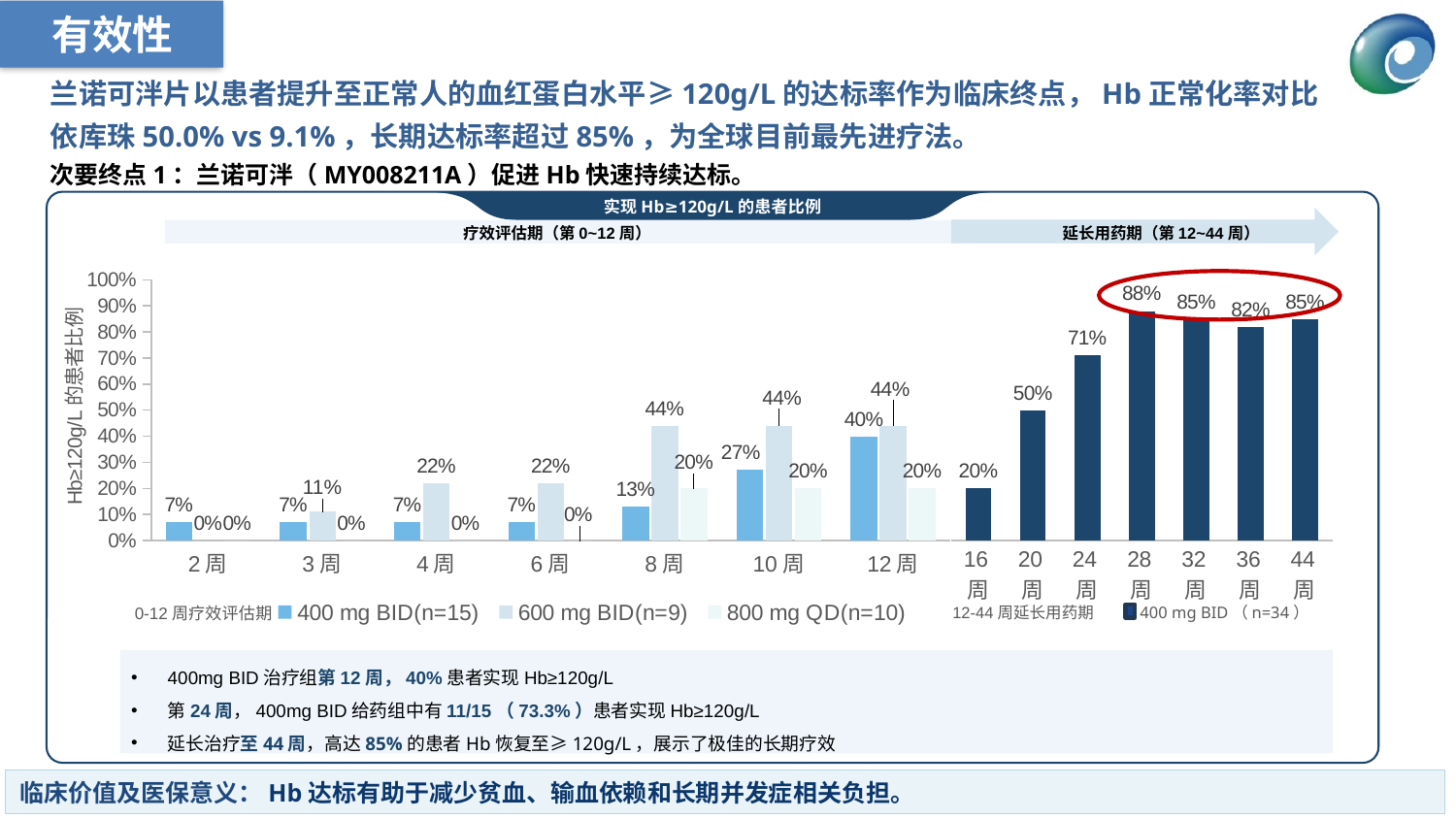
How many series does the legend list for the 0-12 周疗效评估期? 3 Which is larger at 12 周: 400 mg BID(n=15) or 600 mg BID(n=9)? 600 mg BID(n=9) What is the value for 600 mg BID(n=9) at 3 周? 11% Which week in the 12-44 周延长用药期 has the highest value? 28 周 What is the value for 400 mg BID at 24 周 in the extension period? 71% What is the difference between the values at 28 周 and 36 周 in the extension period? 6% Do the values for 400 mg BID rise or fall from 16 周 to 28 周? rise What is the value for 600 mg BID(n=9) at 8 周? 44% What type of chart is shown on the slide? bar chart What is the y-axis label of the chart? Hb≥120g/L 的患者比例 What is the value for 400 mg BID(n=15) at 12 周? 40% What is the value for 800 mg QD(n=10) at 10 周? 20%